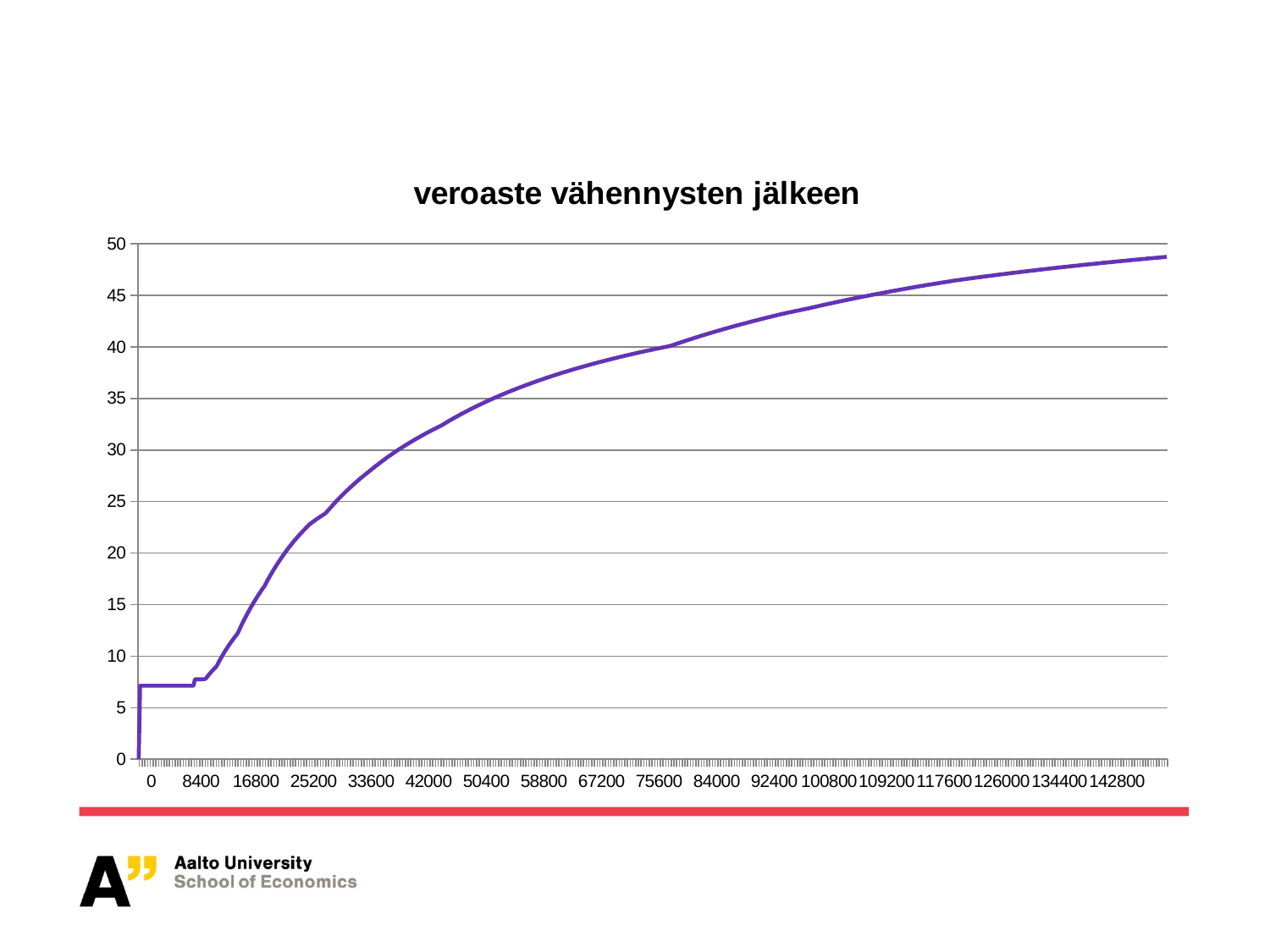
Is the value at x = 142800 greater or less than 45? greater Is the value at x = 33600 greater or less than 25? greater What colour is the plotted line? purple Is the value at x = 8400 greater or less than 10? less What kind of chart is shown on the slide? line chart Do the values generally rise or fall as the x axis increases? rise What is the title of the chart? veroaste vähennysten jälkeen